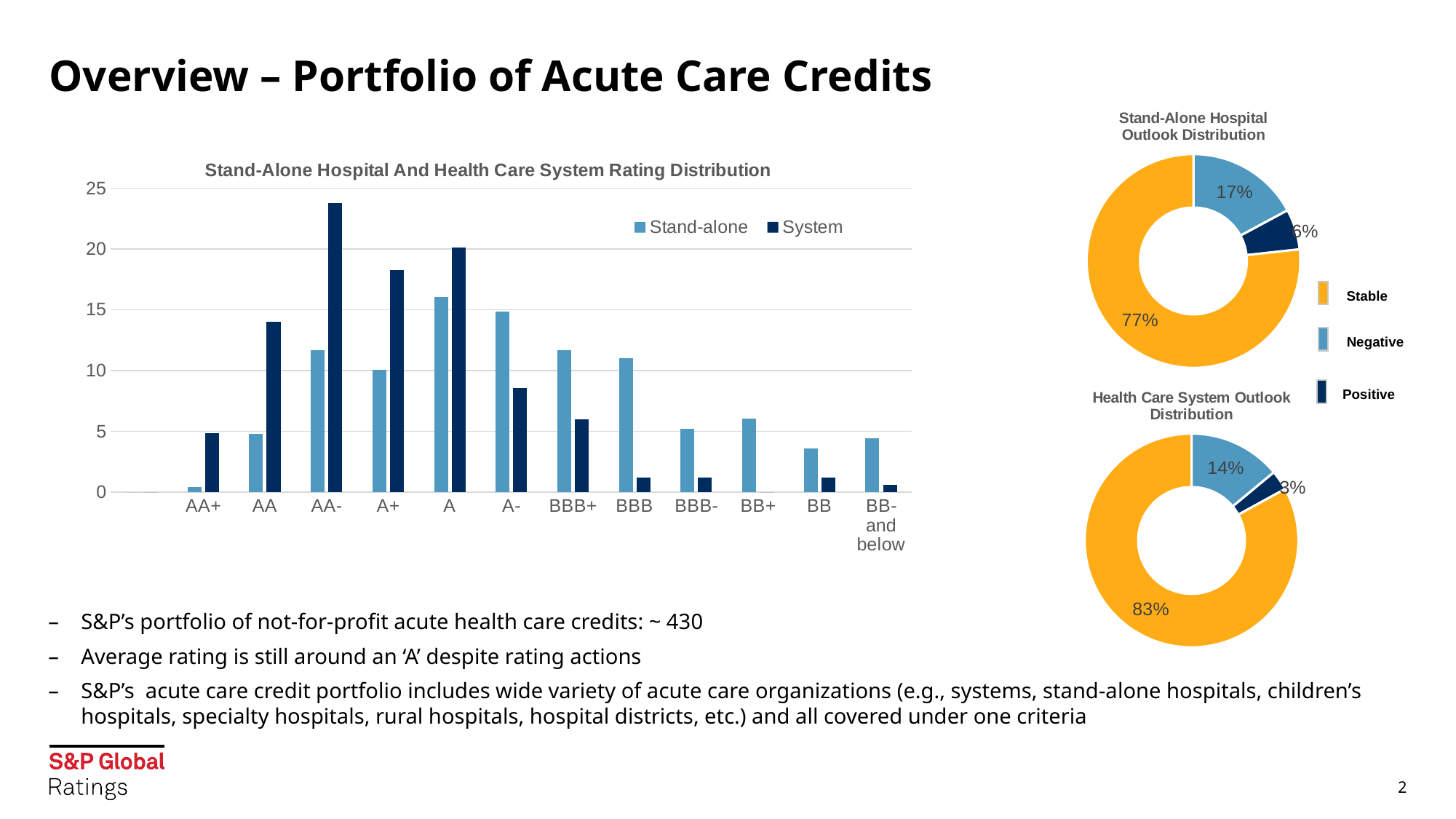
In the 'Health Care System Outlook Distribution' chart, what share is Stable? 83% In the 'Stand-Alone Hospital And Health Care System Rating Distribution' chart, which is larger at AA: the Stand-alone value or the System value? System In the 'Stand-Alone Hospital And Health Care System Rating Distribution' chart, which rating category has the highest System value? AA- How many series does the legend of the 'Stand-Alone Hospital And Health Care System Rating Distribution' chart list? 2 How many rating categories are shown on the x axis of the 'Stand-Alone Hospital And Health Care System Rating Distribution' chart? 12 In the 'Stand-Alone Hospital And Health Care System Rating Distribution' chart, which is larger at BBB: the Stand-alone value or the System value? Stand-alone In the 'Stand-Alone Hospital Outlook Distribution' chart, what share is Stable? 77% What kind of chart is the 'Stand-Alone Hospital And Health Care System Rating Distribution' chart? Bar chart In the 'Stand-Alone Hospital And Health Care System Rating Distribution' chart, is the System value for AA- greater or less than 20? greater In the 'Stand-Alone Hospital Outlook Distribution' chart, what share is Negative? 17% In the 'Stand-Alone Hospital And Health Care System Rating Distribution' chart, which rating category has the highest Stand-alone value? A In the 'Stand-Alone Hospital And Health Care System Rating Distribution' chart, is the Stand-alone value for A- greater or less than 10? greater